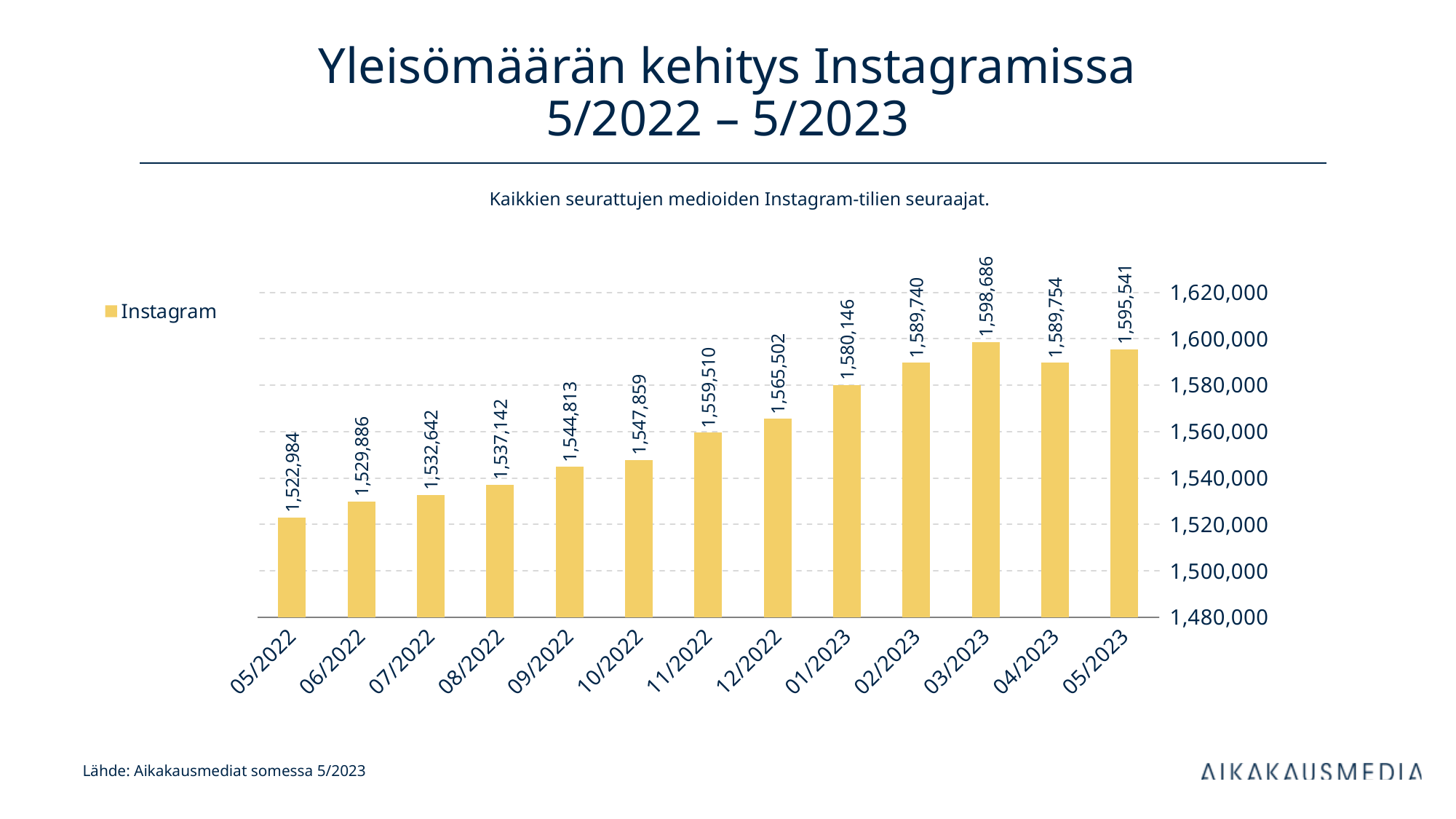
Which is larger, the value for 11/2022 or the value for 09/2022? 11/2022 What is the difference between the values for 03/2023 and 04/2023? 8,932 What is the value for 05/2023? 1,595,541 Which month has the lowest value? 05/2022 What is the difference between the values for 05/2023 and 05/2022? 72,557 How many series does the legend list? 1 What is the value for 05/2022? 1,522,984 How many months are shown on the x axis? 13 What is the value for 12/2022? 1,565,502 What kind of chart is shown on the slide? bar chart Is the value for 10/2022 greater or less than 1,560,000? less Which month has the highest value? 03/2023